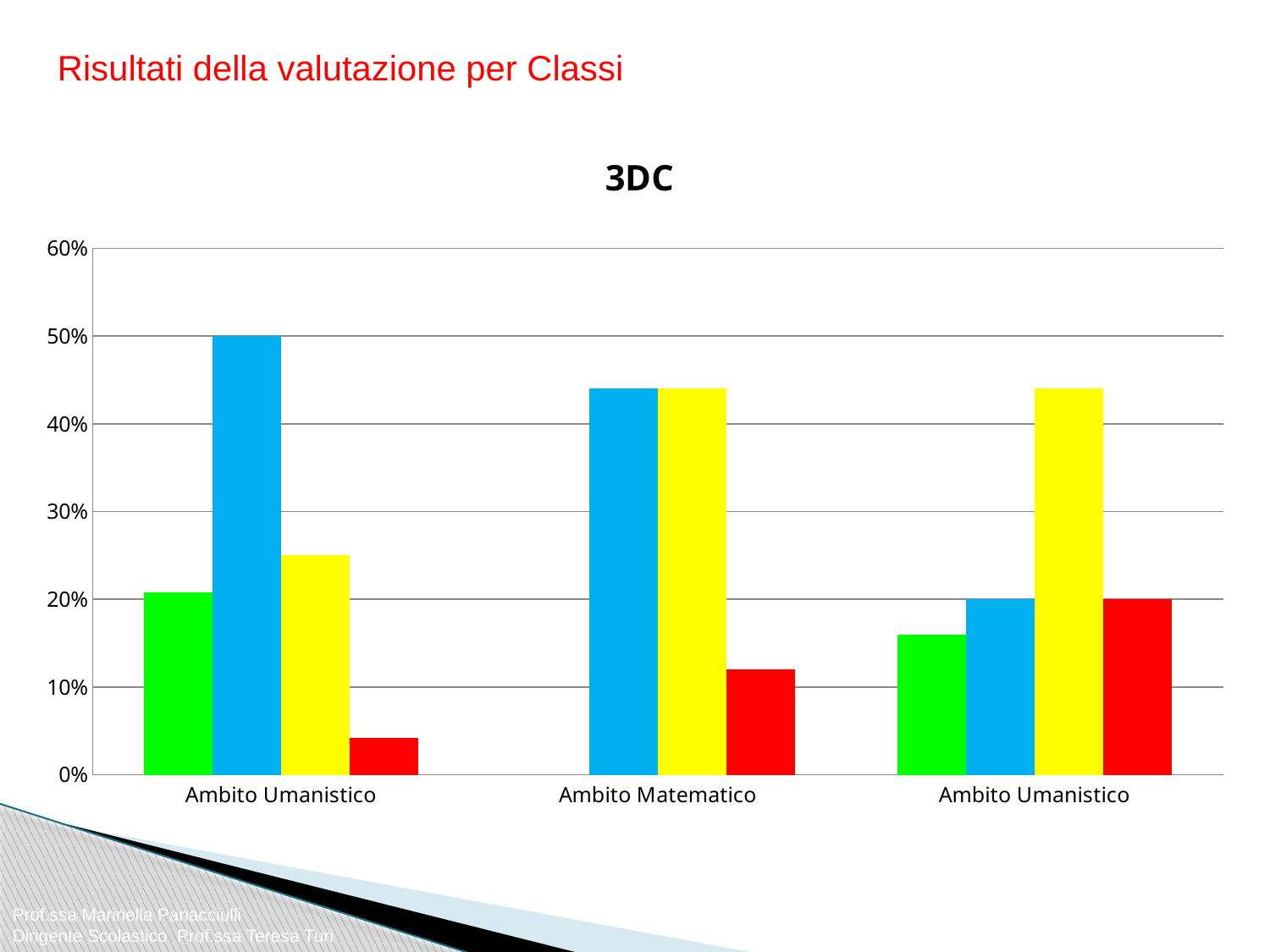
What is the value of the blue bar in the third (right) Ambito Umanistico group? 20% What kind of chart is shown on the slide? bar chart In the first (left) Ambito Umanistico group, which is larger, the green bar or the yellow bar? yellow Which coloured bar is the shortest in the Ambito Matematico group? red What is the value of the blue bar in the first (left) Ambito Umanistico group? 50% Which coloured bar is the tallest in the third (right) Ambito Umanistico group? yellow What is the value of the red bar in the third (right) Ambito Umanistico group? 20% Is the value of the yellow bar in the Ambito Matematico group greater or less than 40%? greater Is the value of the red bar in the first (left) Ambito Umanistico group greater or less than 10%? less What is the title of the chart? 3DC Which coloured bar is the tallest in the first (left) Ambito Umanistico group? blue How many category groups are shown along the x axis? 3